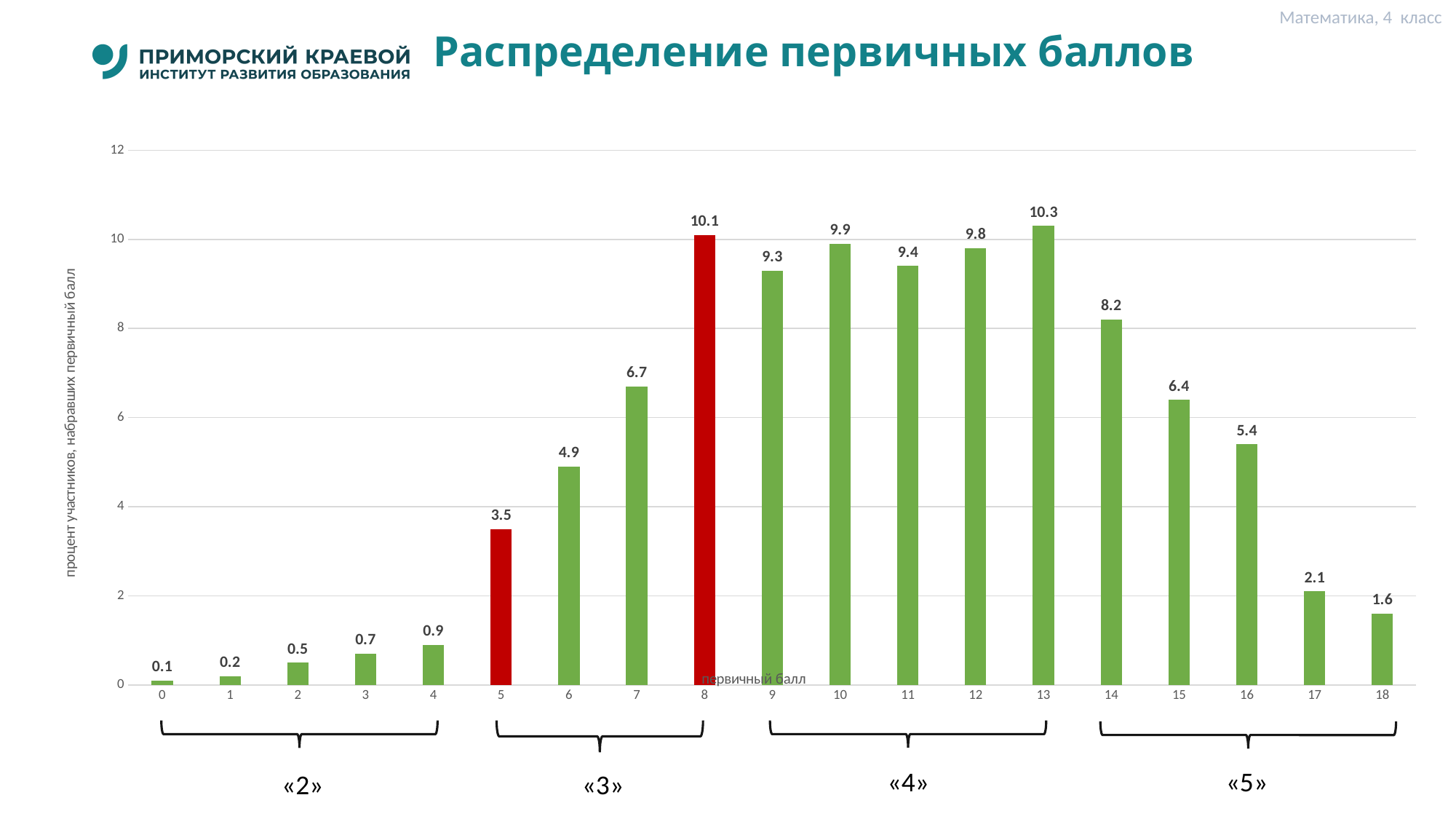
Which primary score has the highest value? 13 Which primary score has the lowest value? 0 What is the value for primary score 8? 10.1 What kind of chart is shown on the slide? bar chart Is the value for primary score 14 greater or less than 8? greater What is the difference between the values for primary scores 13 and 8? 0.2 What is the value for primary score 0? 0.1 Which is larger, the value for primary score 10 or for primary score 12? 10 What is the value for primary score 13? 10.3 Which primary scores are shown with red bars? 5 and 8 How many primary score categories are shown on the x axis? 19 Do the values rise or fall from primary score 13 to primary score 18? fall